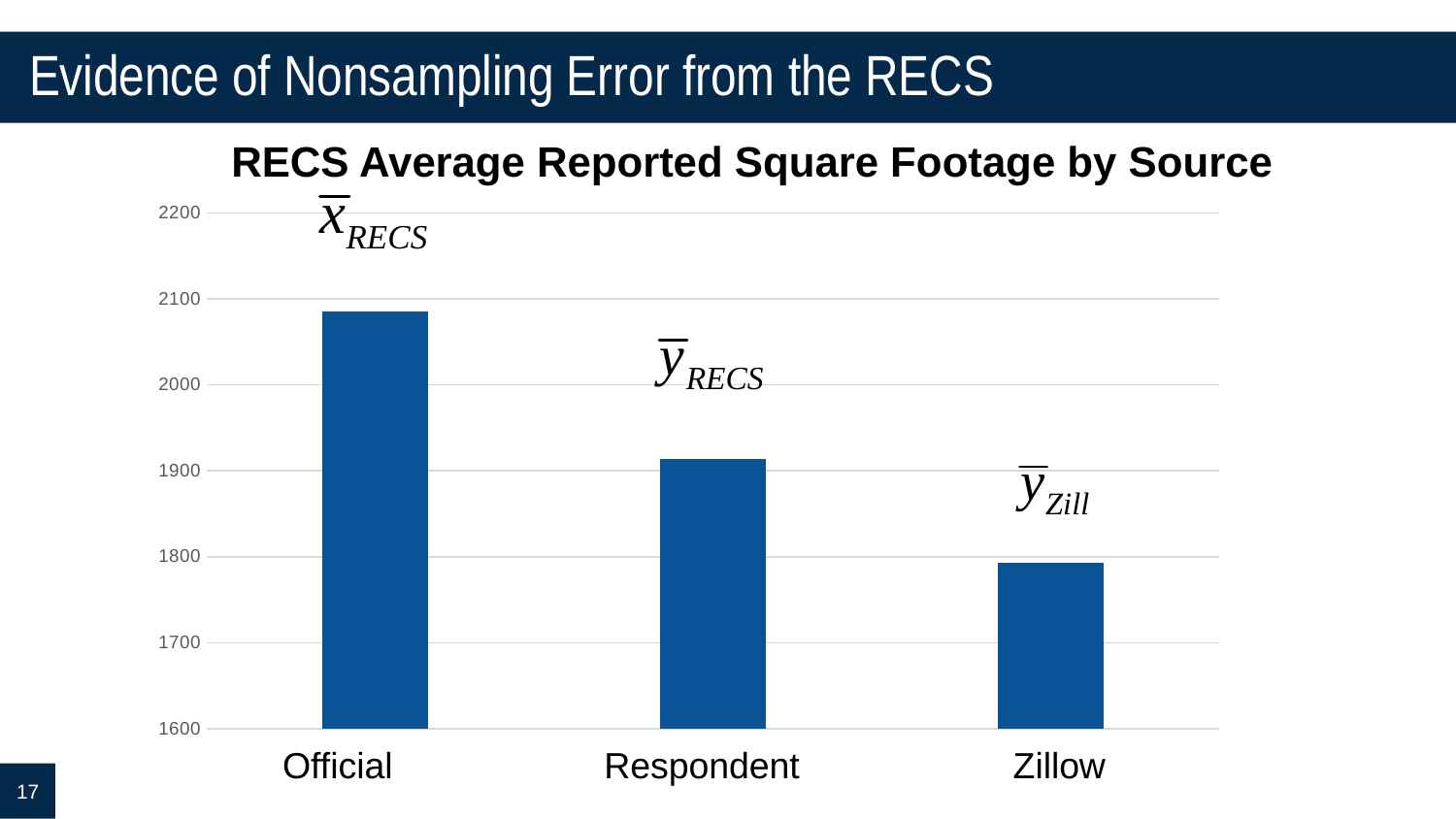
Is the value for Respondent greater or less than 2000? less What is the lowest value shown on the vertical axis? 1600 What kind of chart is shown on the slide? bar chart Which is larger, the value for Respondent or the value for Zillow? Respondent Is the value for Zillow greater or less than 1900? less Do the bar values rise or fall moving from Official to Zillow along the x axis? fall How many sources (categories) are plotted in the chart? 3 What is the title of the chart? RECS Average Reported Square Footage by Source Which source has the highest average reported square footage? Official Which source has the lowest average reported square footage? Zillow Which is larger, the value for Official or the value for Respondent? Official Is the value for Official greater or less than 2000? greater